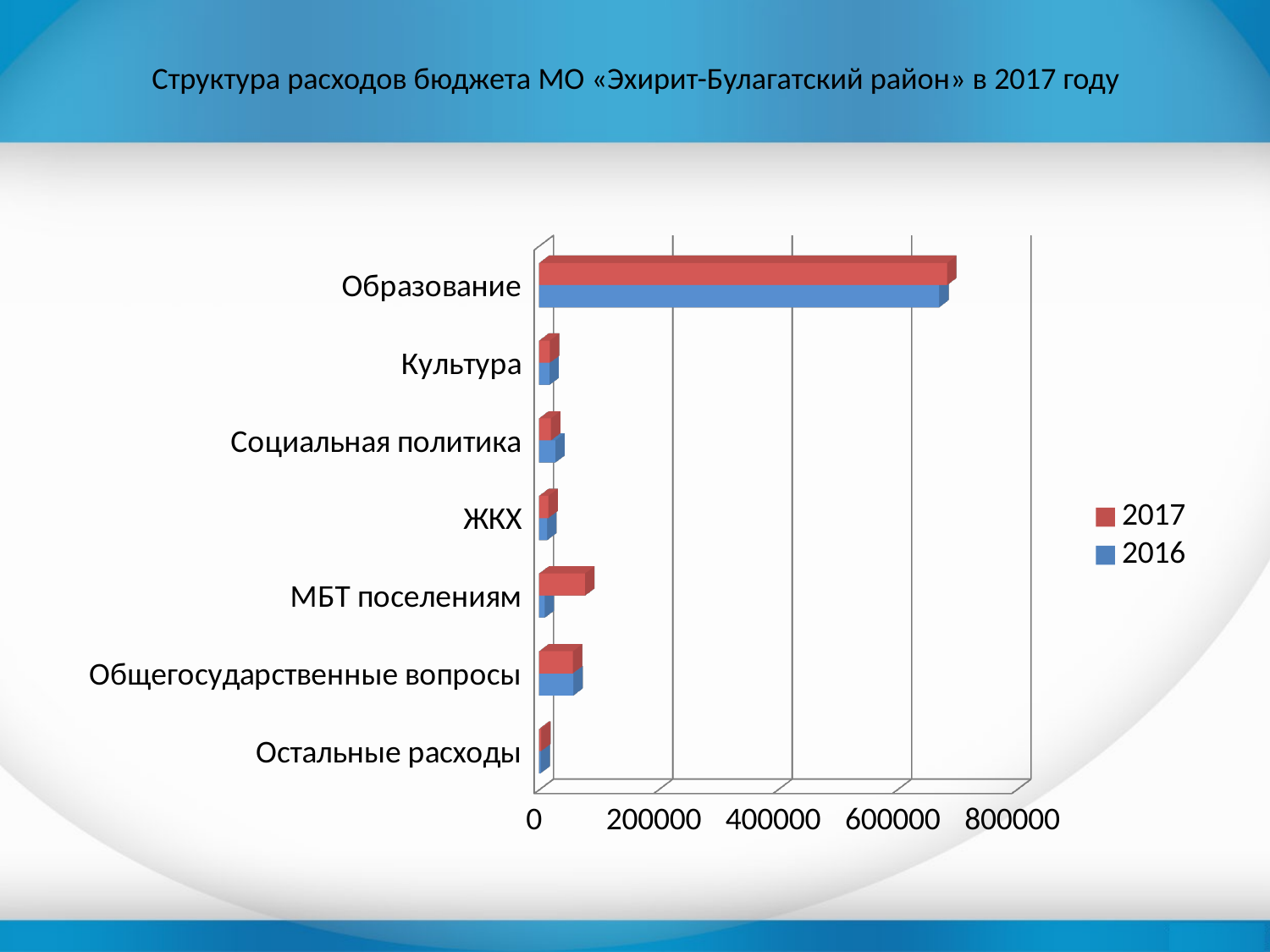
Is the 2016 value for Образование greater or less than 800000? less Which category has the highest value in 2016? Образование What colour represents the 2016 series? blue Which series are listed in the legend? 2017 and 2016 How many series does the legend list? 2 What kind of chart is shown on the slide? bar chart Which category has the highest value in 2017? Образование How many expenditure categories are shown on the chart? 7 For МБТ поселениям, which year has the larger value, 2017 or 2016? 2017 In 2017, which is larger: Общегосударственные вопросы or Культура? Общегосударственные вопросы Is the 2017 value for Образование greater or less than 600000? greater Is the 2017 value for Культура greater or less than 200000? less